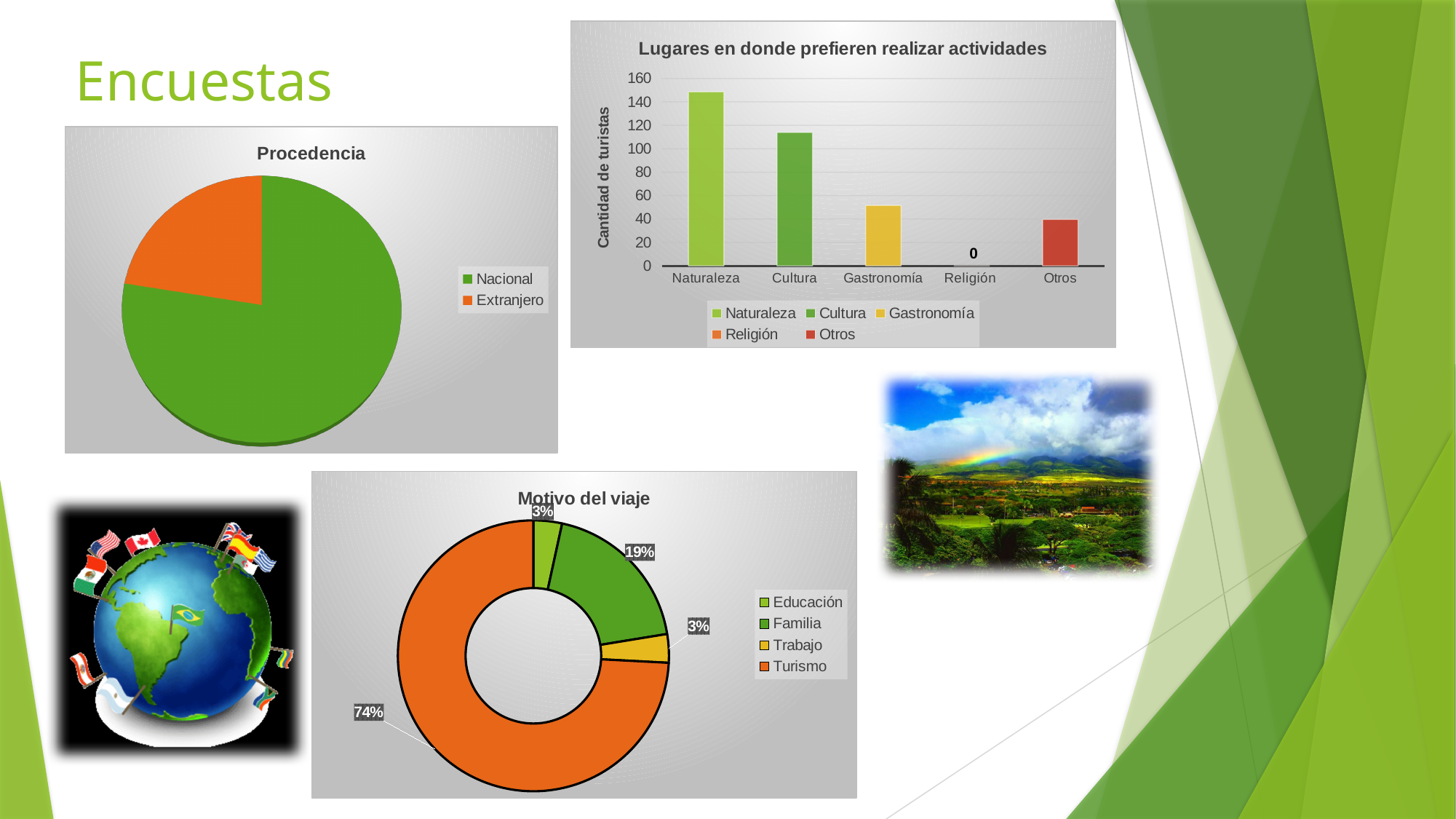
In the 'Lugares en donde prefieren realizar actividades' chart, what is the value for Religión? 0 In the 'Procedencia' chart, which is larger, Nacional or Extranjero? Nacional In the 'Lugares en donde prefieren realizar actividades' chart, is the value for Cultura greater or less than 100? greater In the 'Lugares en donde prefieren realizar actividades' chart, is the value for Otros greater or less than 60? less In the 'Motivo del viaje' chart, what is the difference between the Turismo and Familia shares? 55% In the 'Motivo del viaje' chart, what share does Turismo have? 74% In the 'Motivo del viaje' chart, what share does Familia have? 19% In the 'Lugares en donde prefieren realizar actividades' chart, which category has the lowest value? Religión How many categories are shown in the 'Lugares en donde prefieren realizar actividades' chart? 5 In the 'Lugares en donde prefieren realizar actividades' chart, which category has the highest value? Naturaleza In the 'Lugares en donde prefieren realizar actividades' chart, is the value for Naturaleza greater or less than 140? greater In the 'Lugares en donde prefieren realizar actividades' chart, which is larger, Cultura or Gastronomía? Cultura